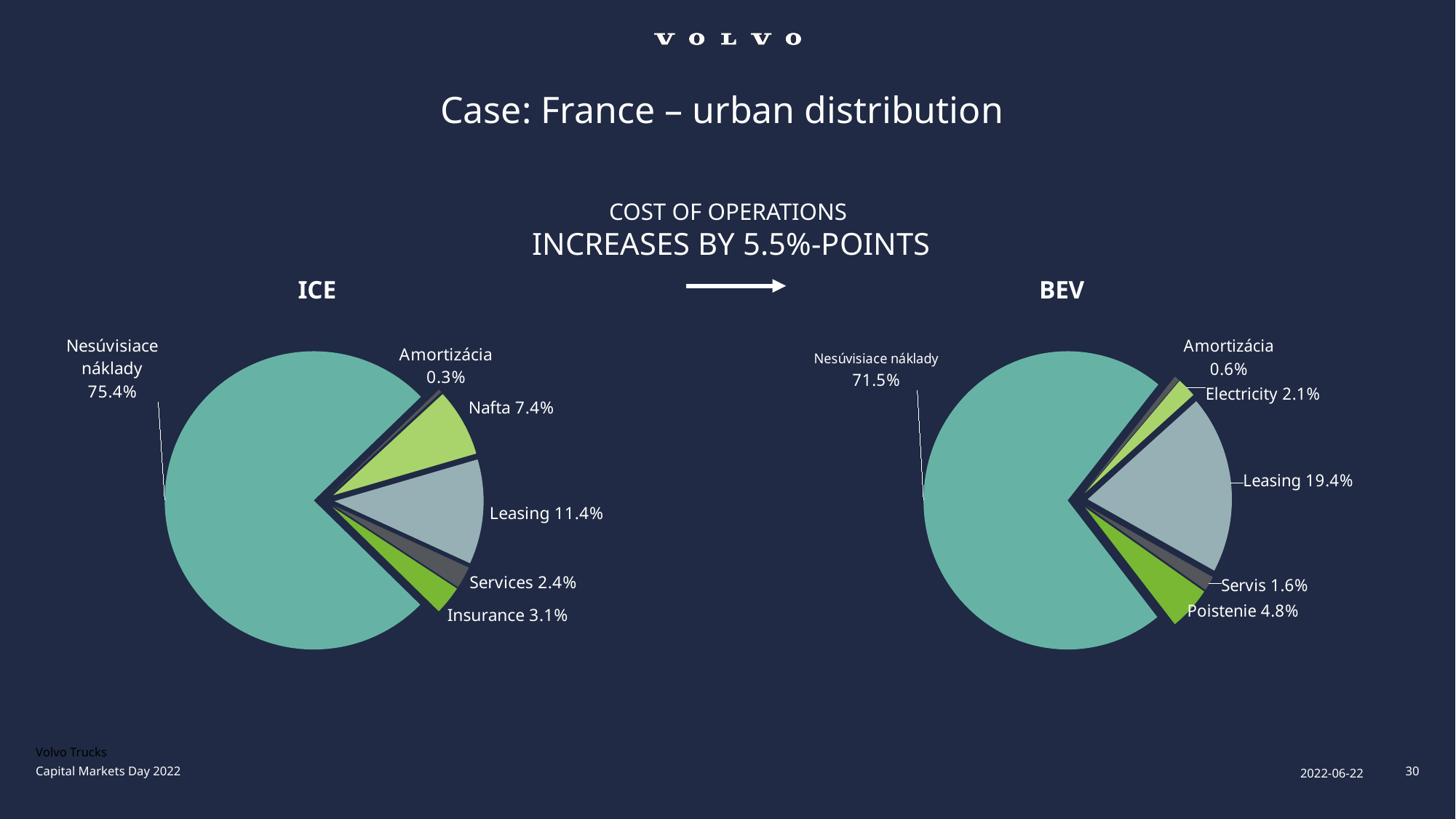
In the ICE pie chart, which category has the smallest share? Amortizácia In the ICE pie chart, what share does Nesúvisiace náklady have? 75.4% In the ICE pie chart, what is the value for Nafta? 7.4% How many slices does the BEV pie chart have? 6 In the BEV pie chart, what share does Leasing have? 19.4% In the BEV pie chart, which category has the largest share? Nesúvisiace náklady How many slices does the ICE pie chart have? 6 What is the difference between the Leasing share in the BEV chart and the Leasing share in the ICE chart? 8.0% What type of chart is used for the ICE and BEV data? Pie chart In the BEV pie chart, what is the value for Electricity? 2.1% In the BEV pie chart, what is the value for Poistenie? 4.8% In the ICE pie chart, which is larger: Services or Insurance? Insurance